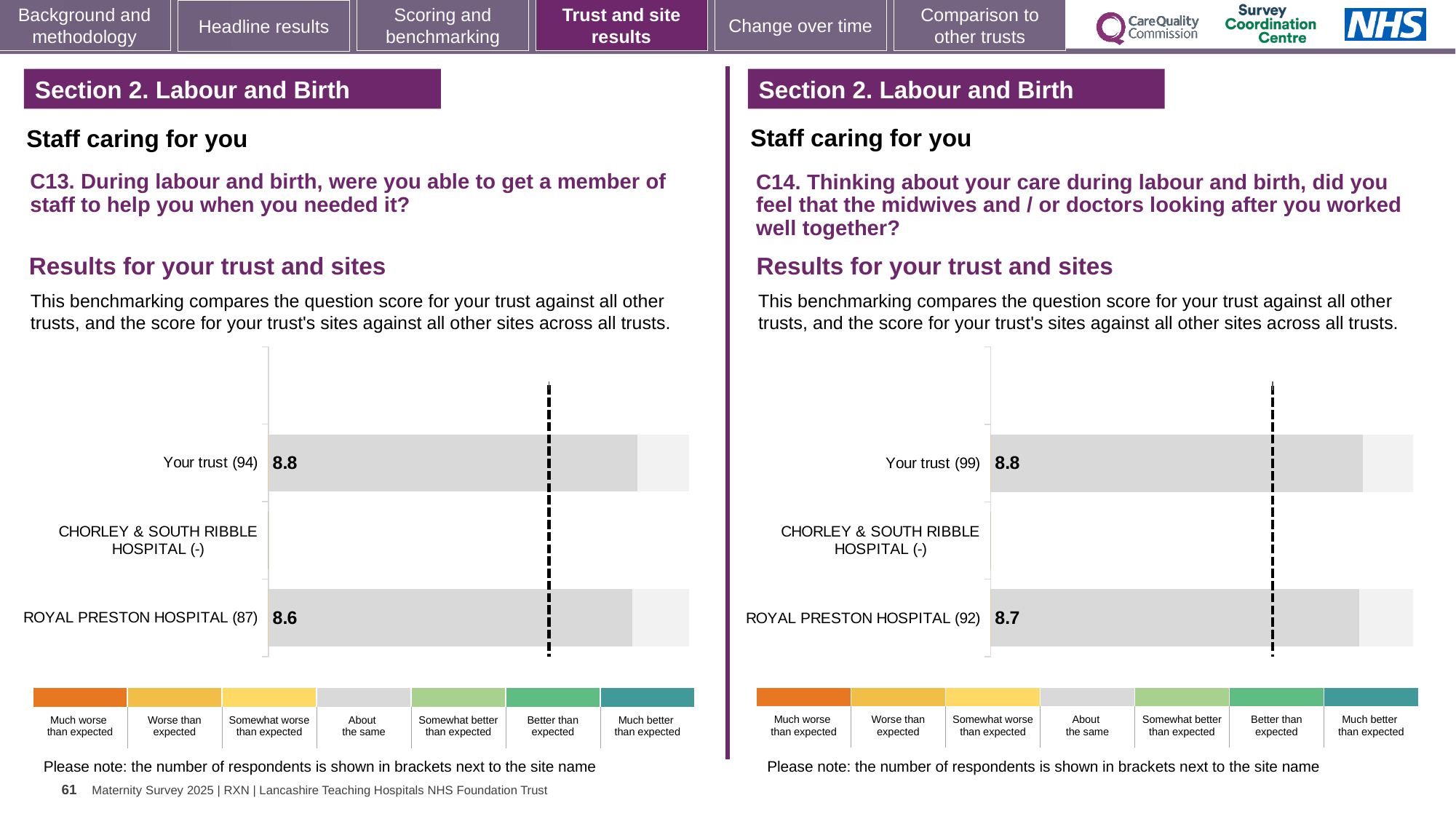
In the C13 chart on the left, what is the score for ROYAL PRESTON HOSPITAL? 8.6 In the C14 chart on the right, which has the higher score, Your trust or ROYAL PRESTON HOSPITAL? Your trust In the C14 chart on the right, how many respondents are shown in brackets for ROYAL PRESTON HOSPITAL? 92 In the C14 chart on the right, what is the score for Your trust? 8.8 In the C13 chart on the left, what is the difference between the score for Your trust and the score for ROYAL PRESTON HOSPITAL? 0.2 In the C14 chart on the right, what is the score for ROYAL PRESTON HOSPITAL? 8.7 In the C13 chart on the left, which has the higher score, Your trust or ROYAL PRESTON HOSPITAL? Your trust How many categories are listed on the vertical axis of the C14 chart on the right? 3 What kind of chart is the C13 chart on the left? Bar chart In the C13 chart on the left, how many respondents are shown in brackets for Your trust? 94 In the C14 chart on the right, what is the difference between the score for Your trust and the score for ROYAL PRESTON HOSPITAL? 0.1 In the C13 chart on the left, what is the score for Your trust? 8.8